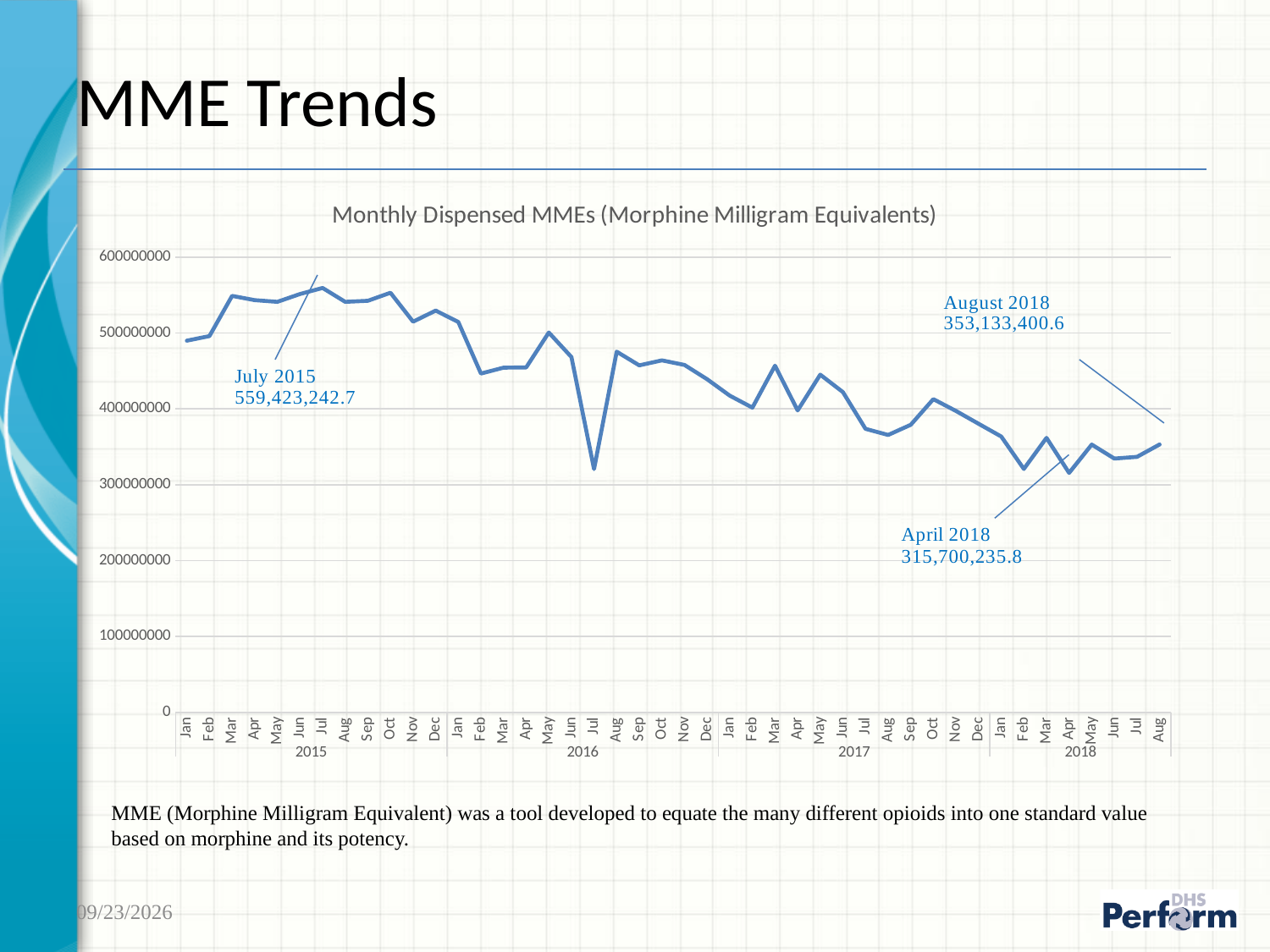
What is the value for April 2018 on the Monthly Dispensed MMEs chart? 315,700,235.8 What is the value for July 2015 on the Monthly Dispensed MMEs chart? 559,423,242.7 Do the monthly dispensed MME values generally rise or fall from 2015 to 2018? fall Which is larger, the value for April 2018 or the value for August 2018? August 2018 What is the difference between the August 2018 value and the April 2018 value? 37,433,164.8 Is the value for July 2016 greater or less than 400000000? less What kind of chart is shown on the slide? line chart Which is larger, the value for July 2015 or the value for August 2018? July 2015 What is the value for August 2018 on the Monthly Dispensed MMEs chart? 353,133,400.6 What is the difference between the July 2015 value and the August 2018 value? 206,289,842.1 What is the title of the chart? Monthly Dispensed MMEs (Morphine Milligram Equivalents) Is the value for October 2015 greater or less than 500000000? greater